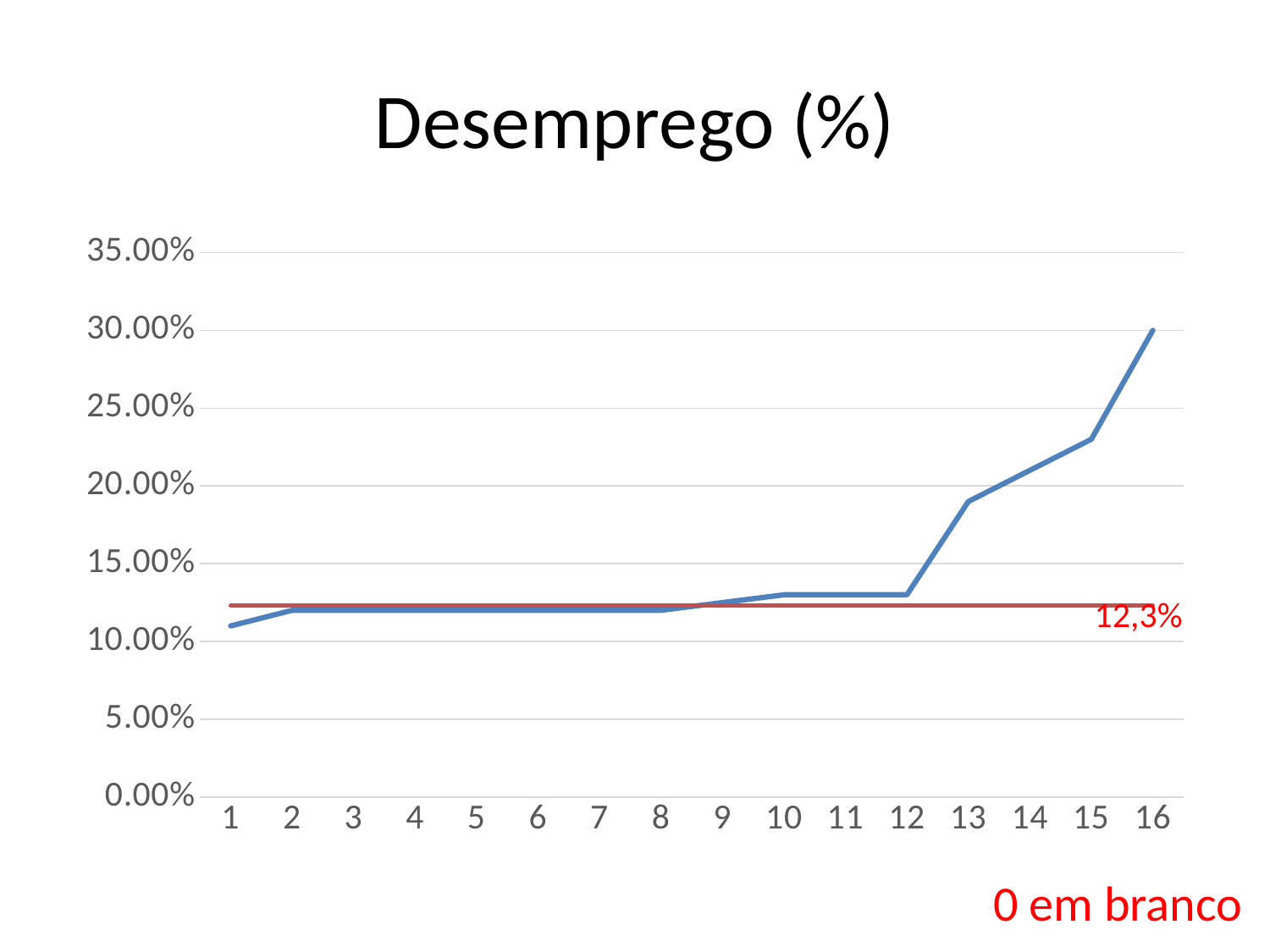
What is the title of the chart? Desemprego (%) At which x-axis point does the blue line reach its highest value? 16 Is the value of the blue line at point 5 greater or less than 15.00%? less Which has a higher value on the blue line, point 10 or point 13? point 13 What kind of chart is shown on the slide? line chart Does the blue line generally rise or fall from point 1 to point 16? rise How many points are plotted along the x axis of the chart? 16 Is the value of the blue line at point 15 greater or less than 20.00%? greater What value is labelled on the red horizontal line in the chart? 12,3% Is the value of the blue line at point 16 greater or less than 25.00%? greater At which x-axis point does the blue line have its lowest value? 1